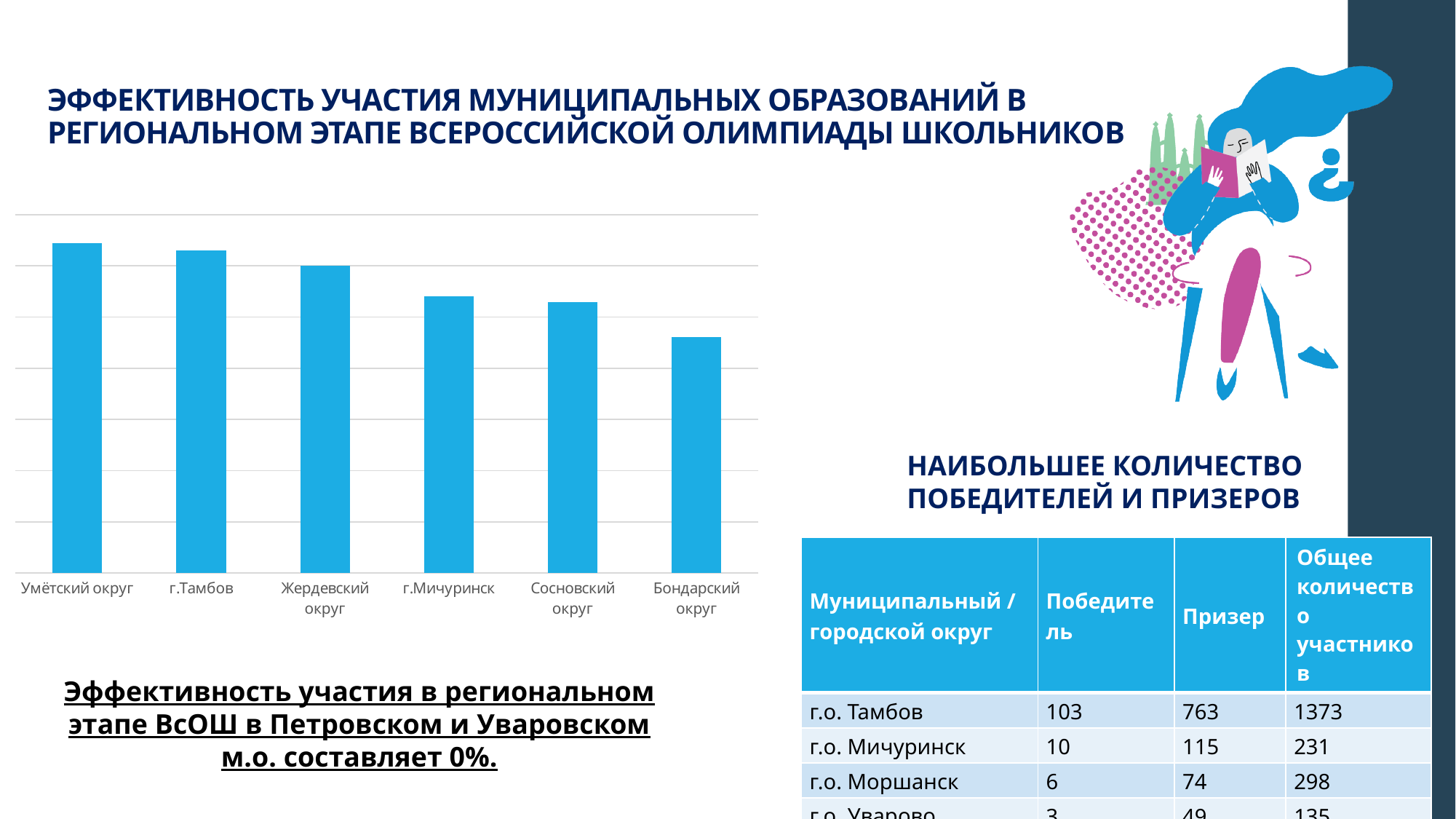
What colour are the bars on the chart? blue What is the label of the first category on the left of the bar chart? Умётский округ Which has the larger value on the chart: Жердевский округ or г.Мичуринск? Жердевский округ Do the bar values rise or fall from left to right along the x axis? fall How many categories (municipal districts) are shown on the bar chart? 6 Which category has the lowest bar on the chart? Бондарский округ Which category has the highest bar on the chart? Умётский округ What kind of chart is shown on the left of the slide? bar chart Which has the larger value on the chart: г.Тамбов or Сосновский округ? г.Тамбов Which has the larger value on the chart: Умётский округ or Бондарский округ? Умётский округ